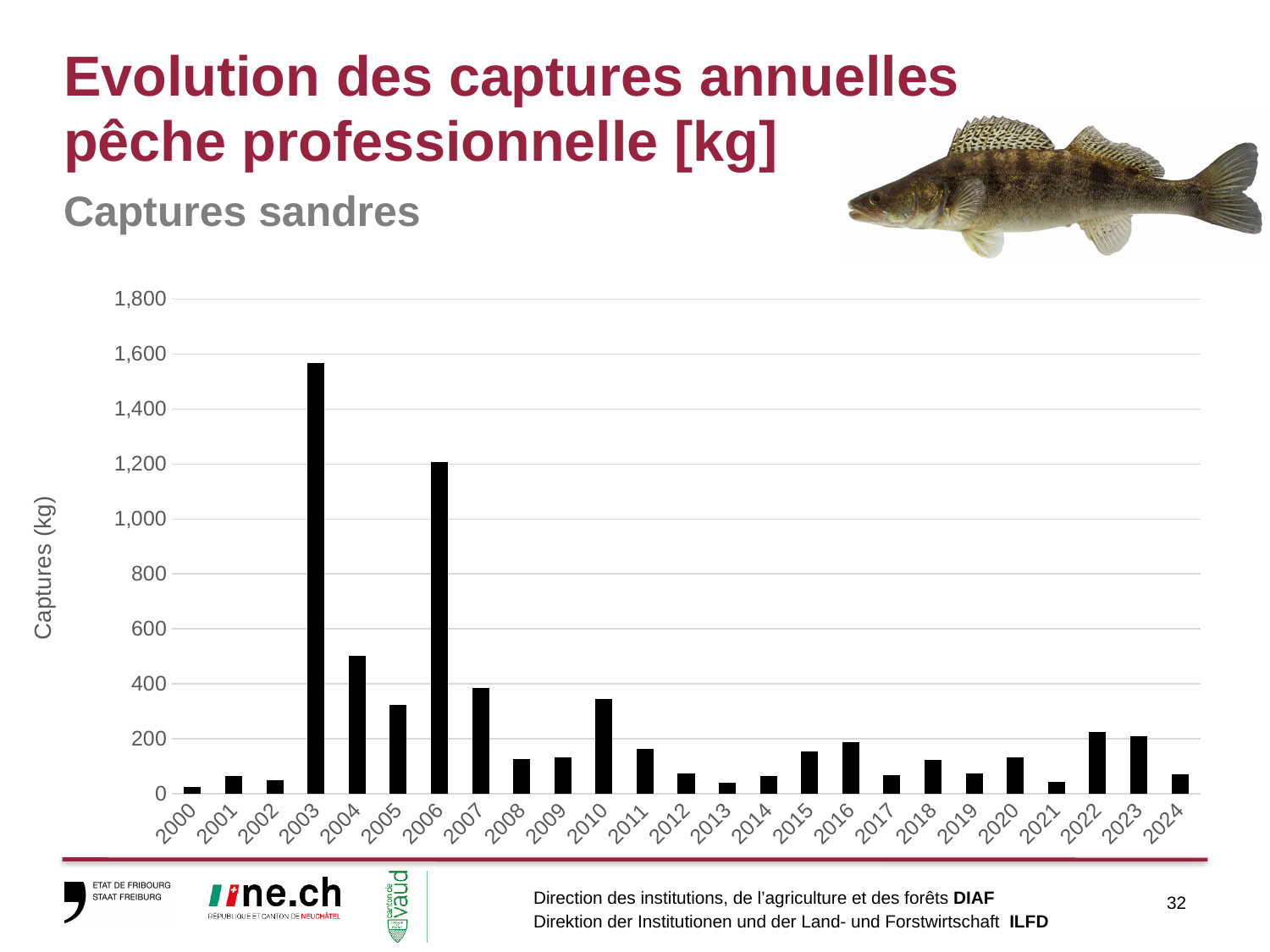
Is the value for 2006 greater or less than 1,000? greater What is the label of the vertical axis of the chart? Captures (kg) Is the value for 2005 greater or less than 400? less Is the value for 2013 greater or less than 100? less How many years are plotted on the x axis of the chart? 25 Which year has the larger catch value, 2003 or 2006? 2003 What kind of chart is shown on the slide? bar chart Which year has the lowest catch value in the chart? 2000 Which year has the larger catch value, 2010 or 2011? 2010 Which year has the highest catch value in the chart? 2003 Which year has the larger catch value, 2004 or 2005? 2004